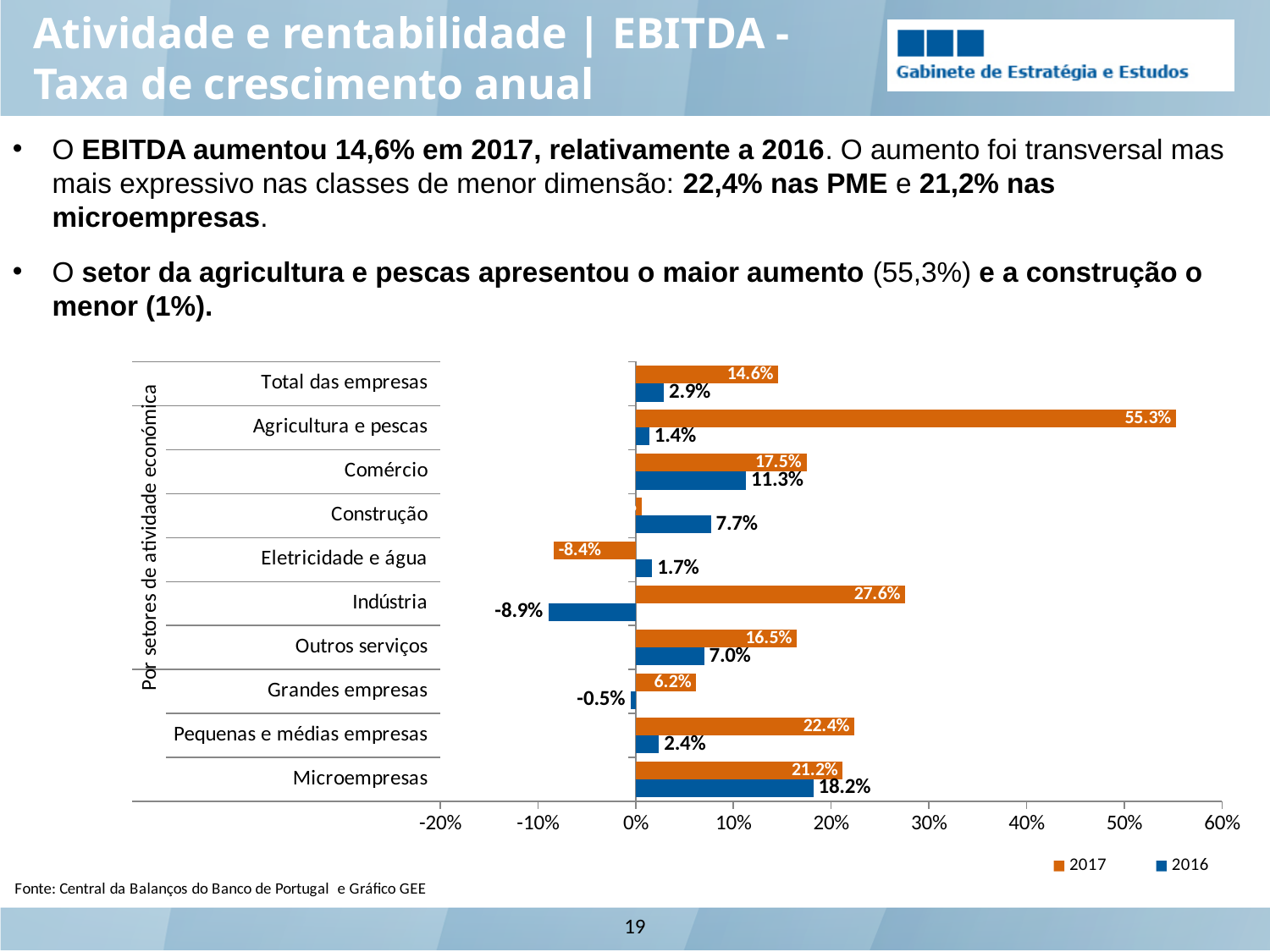
How many series does the legend list? 2 Which category has the highest 2017 value? Agricultura e pescas How many categories are shown on the chart? 10 Which is larger for Comércio, the 2017 value or the 2016 value? 2017 Which colour represents the 2016 series in the legend? blue Is the 2017 value for Construção greater or less than 10%? less What type of chart is shown on the slide? bar chart What is the 2017 value for Agricultura e pescas? 55.3% What is the difference between the 2017 and 2016 values for Microempresas? 3.0% What is the 2016 value for Indústria? -8.9% Which category has the lowest 2016 value? Indústria What is the 2017 value for Pequenas e médias empresas? 22.4%